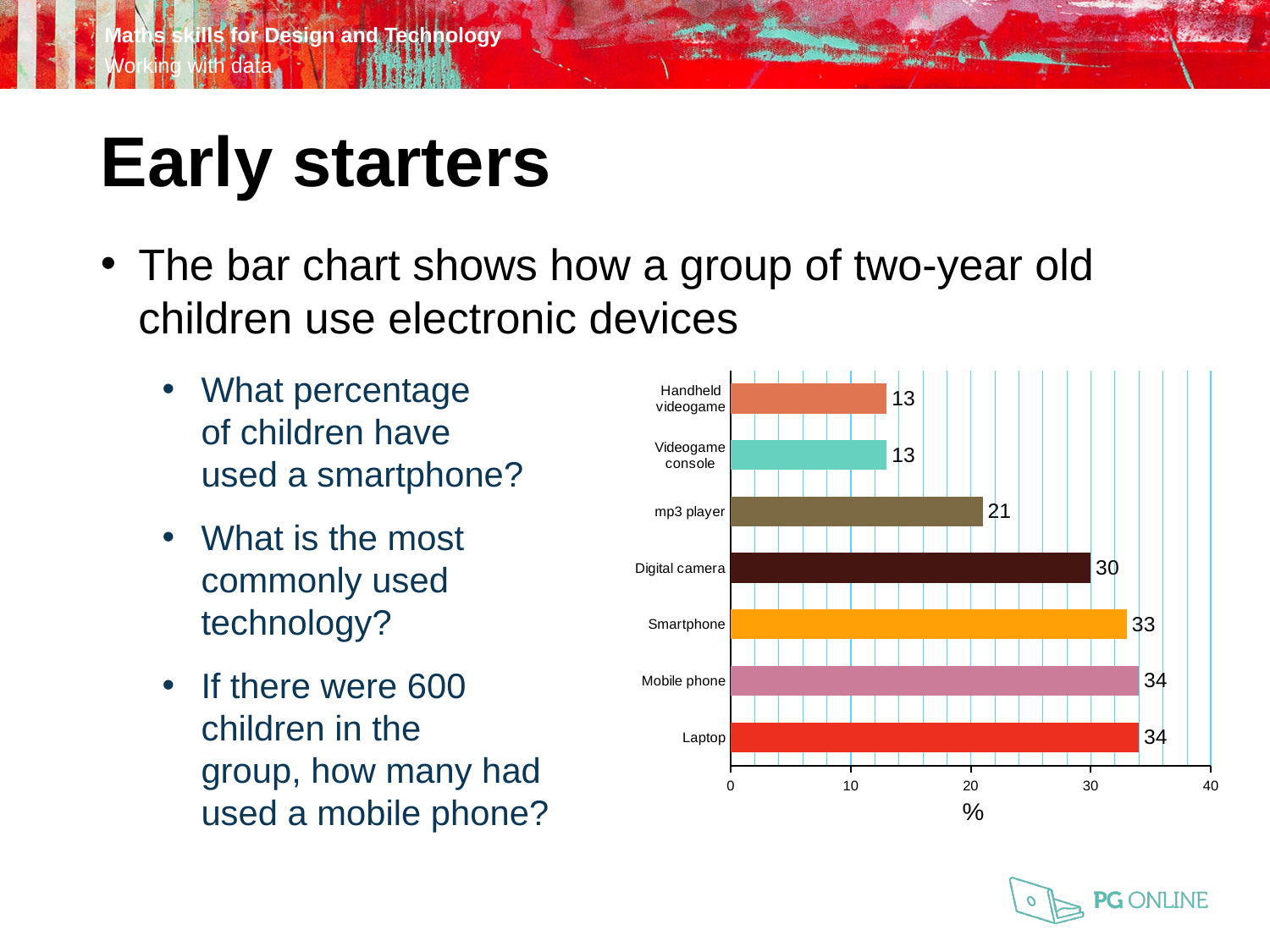
What value is shown for mp3 player? 21 How many categories are shown in the chart? 7 What is the label on the horizontal axis of the chart? % What kind of chart is shown on the slide? bar chart What value is shown for Digital camera? 30 What is the difference between the values for Mobile phone and Smartphone? 1 What is the difference between the values for Digital camera and Handheld videogame? 17 What value is shown for Smartphone? 33 Which has a larger value, Digital camera or mp3 player? Digital camera Is the value for Smartphone greater or less than 30? greater What value is shown for Laptop? 34 What value is shown for Videogame console? 13